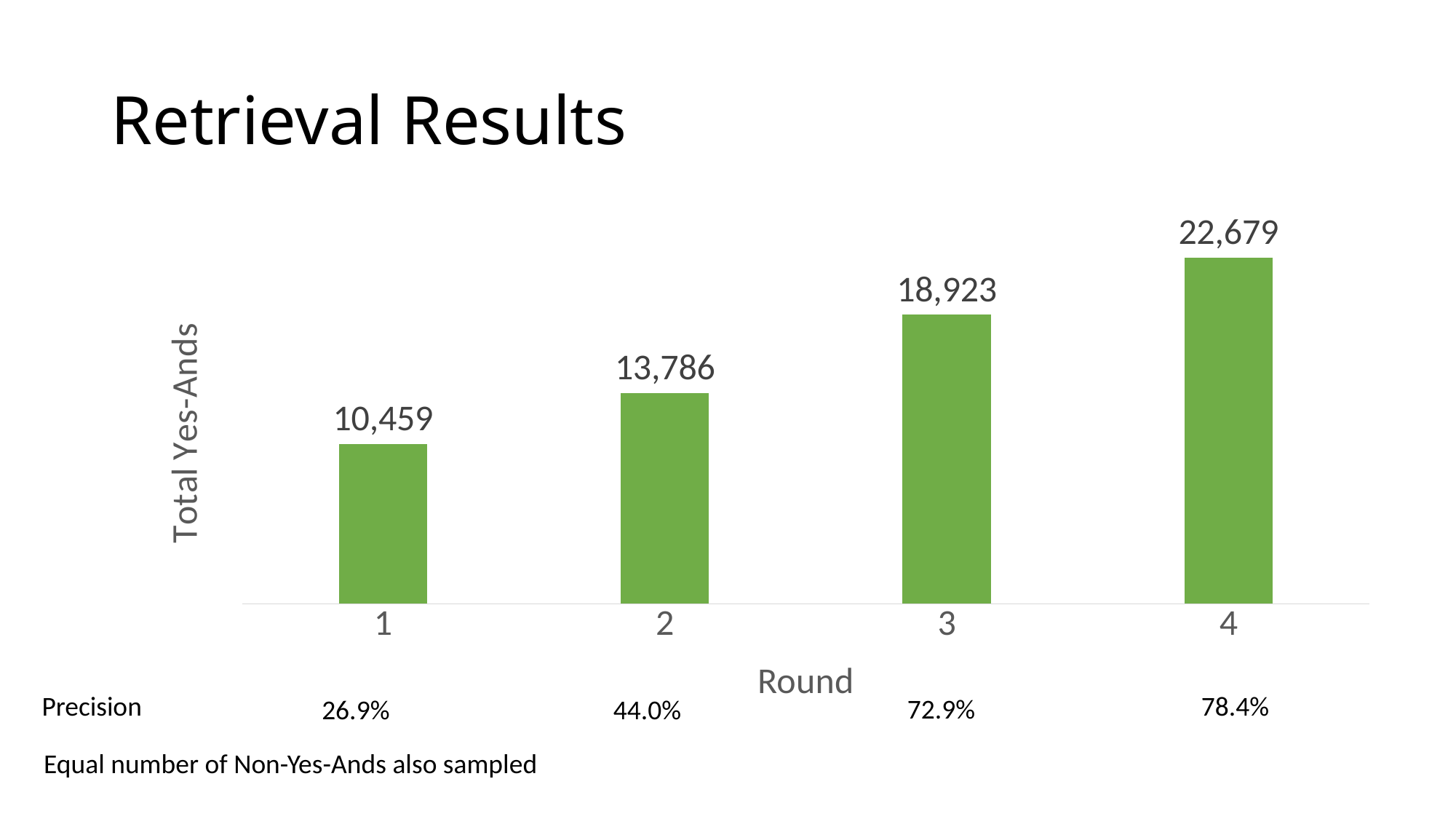
What kind of chart is shown on the slide? bar chart What is the difference in total Yes-Ands between Round 4 and Round 1? 12,220 Which round has more total Yes-Ands, Round 2 or Round 3? 3 What is the total Yes-Ands value for Round 3? 18,923 How many rounds are shown on the chart? 4 What is the label of the vertical axis of the chart? Total Yes-Ands What is the total Yes-Ands value for Round 1? 10,459 Which round has the lowest total Yes-Ands? 1 Which round has the highest total Yes-Ands? 4 What is the difference in total Yes-Ands between Round 3 and Round 2? 5,137 What is the total Yes-Ands value for Round 4? 22,679 Do the total Yes-Ands values rise or fall from Round 1 to Round 4? rise